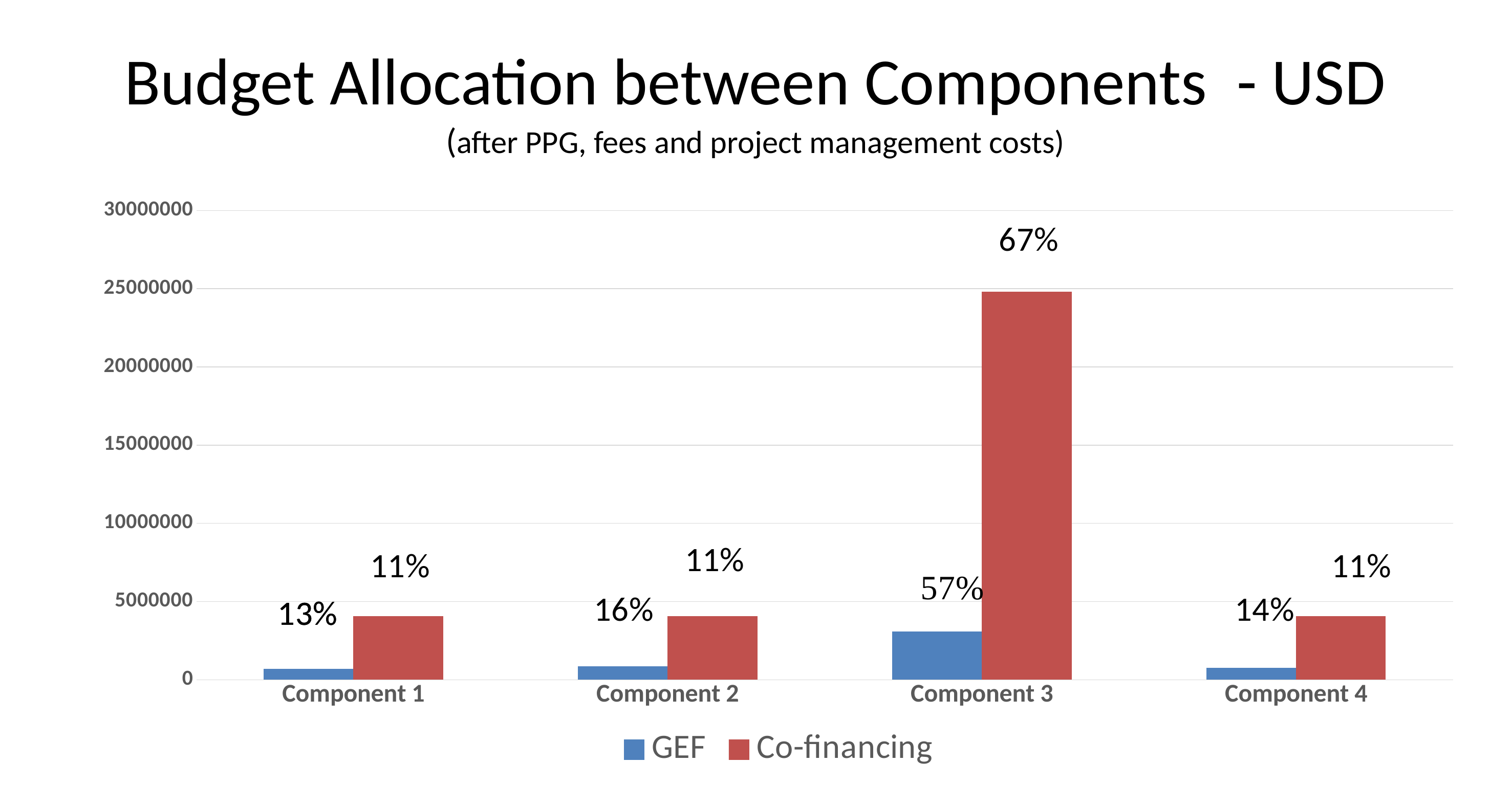
What percentage label is printed above the GEF bar for Component 2? 16% Which series is shown in red in the legend? Co-financing Is the Co-financing value for Component 3 greater or less than 20000000? greater How many series does the legend list? 2 What percentage label is printed above the Co-financing bar for Component 3? 67% What percentage label is printed above the GEF bar for Component 4? 14% Is the GEF value for Component 3 greater or less than 5000000? less Which component has the highest GEF bar? Component 3 What kind of chart is shown on the slide? bar chart How many components are shown on the x axis? 4 Which component has the highest Co-financing bar? Component 3 Which is larger, the GEF bar for Component 3 or the GEF bar for Component 1? GEF bar for Component 3